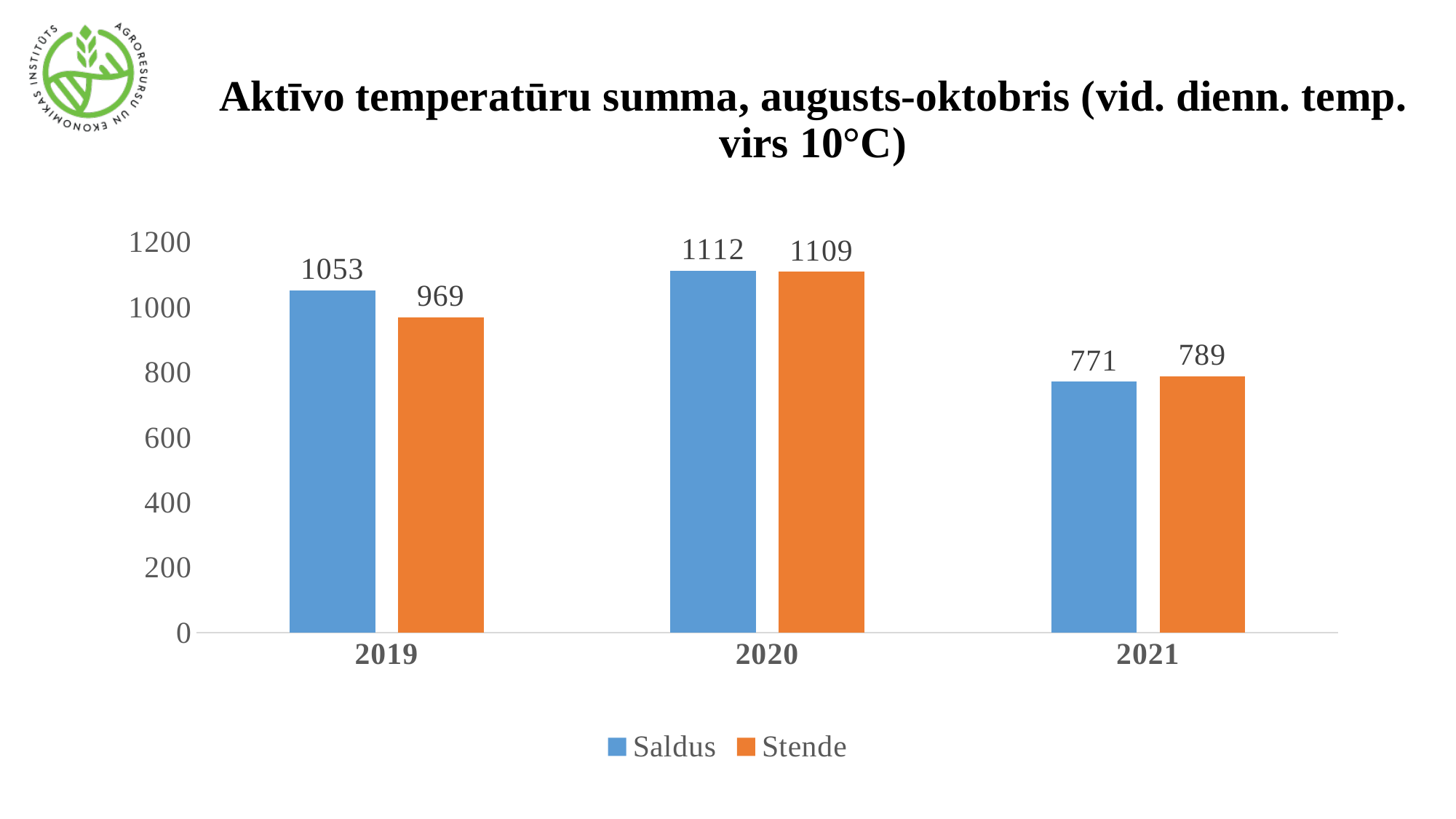
What is the value for Stende in 2020? 1109 What is the difference between the Saldus and Stende values in 2019? 84 What kind of chart is shown on the slide? bar chart What is the difference between the Saldus values in 2020 and 2021? 341 What is the value for Saldus in 2019? 1053 In which year is the Saldus value highest? 2020 Which is larger in 2019, the Saldus value or the Stende value? Saldus What is the value for Stende in 2021? 789 In which year is the Stende value lowest? 2021 Is the value for Saldus in 2021 greater or less than 800? less How many years are shown on the x axis? 3 How many series does the legend list? 2